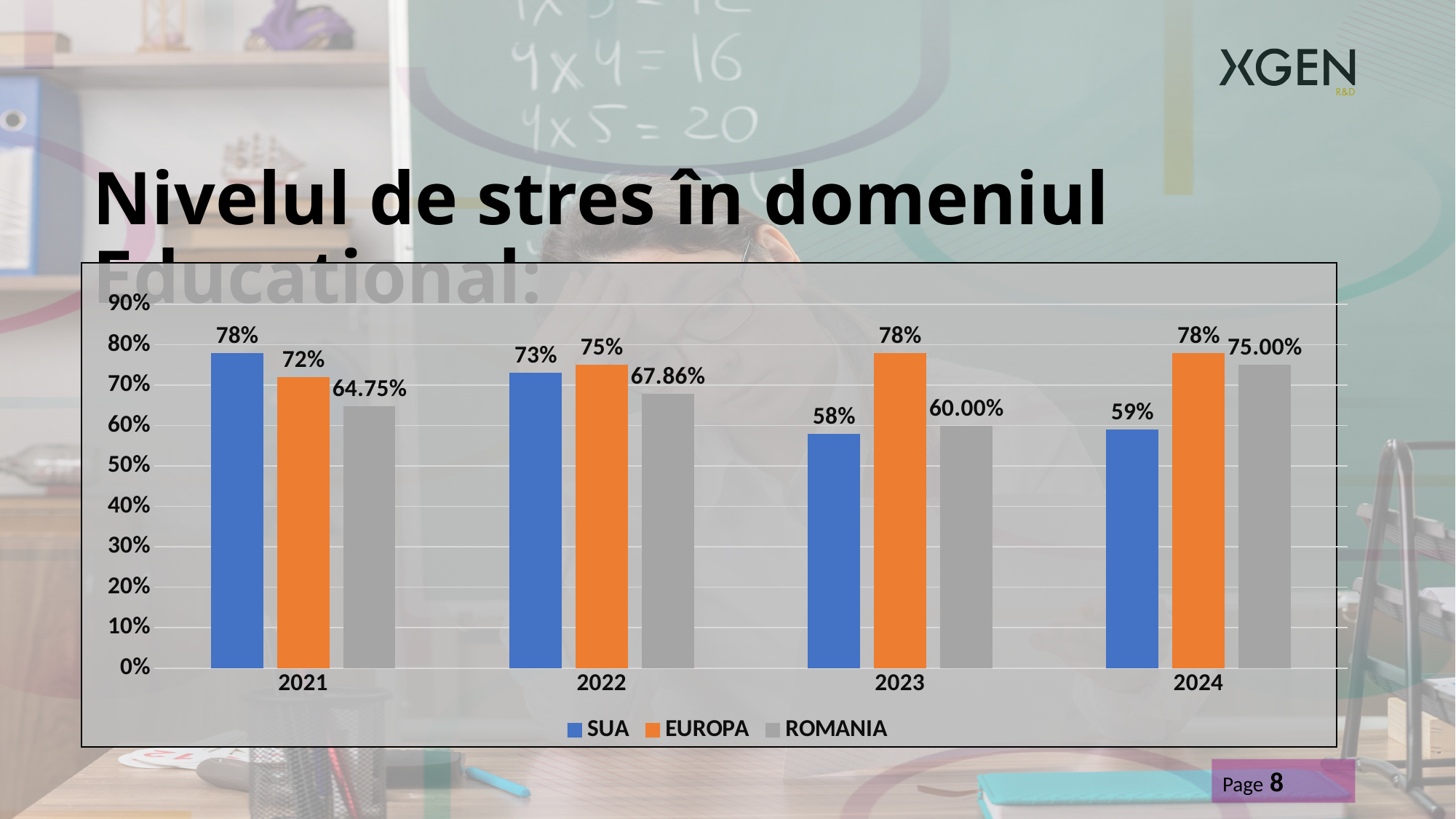
Which colour represents ROMANIA in the chart? Grey What kind of chart is shown on the slide? Bar chart Which series has the highest value in 2024? EUROPA What is the value for EUROPA in 2023? 78% What is the value for ROMANIA in 2024? 75.00% What is the value for SUA in 2021? 78% Which is larger in 2022, the SUA value or the EUROPA value? EUROPA In which year is the SUA value lowest? 2023 What is the difference between the SUA and EUROPA values in 2023? 20% How many series does the legend list? 3 How many years are shown on the x axis? 4 What is the value for ROMANIA in 2022? 67.86%